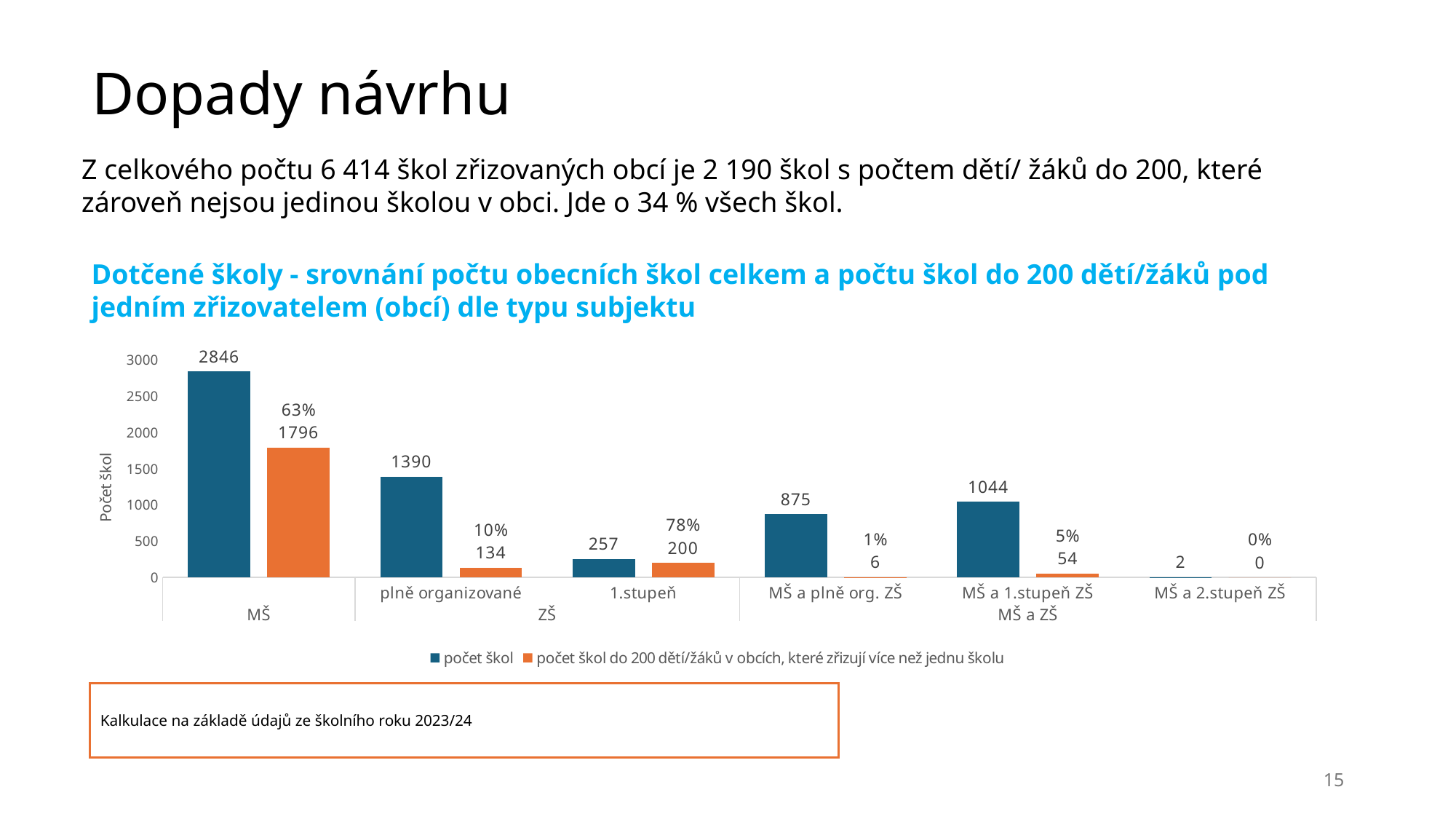
What is the value of "počet škol do 200 dětí/žáků v obcích, které zřizují více než jednu školu" for 1.stupeň? 200 How many categories are shown on the x axis? 6 What is the difference between "počet škol" and "počet škol do 200 dětí/žáků v obcích, které zřizují více než jednu školu" for MŠ? 1050 Which category has the highest value of "počet škol"? MŠ Which category has the lowest value of "počet škol"? MŠ a 2.stupeň ZŠ Which is larger: "počet škol" for plně organizované or "počet škol" for MŠ a 1.stupeň ZŠ? plně organizované How many series does the legend list? 2 What percentage is shown above the orange bar for plně organizované? 10% What kind of chart is shown on the slide? bar chart What is the value of "počet škol" for MŠ? 2846 What is the value of "počet škol" for MŠ a 1.stupeň ZŠ? 1044 Is the value of "počet škol" for MŠ a plně org. ZŠ greater or less than 1000? less